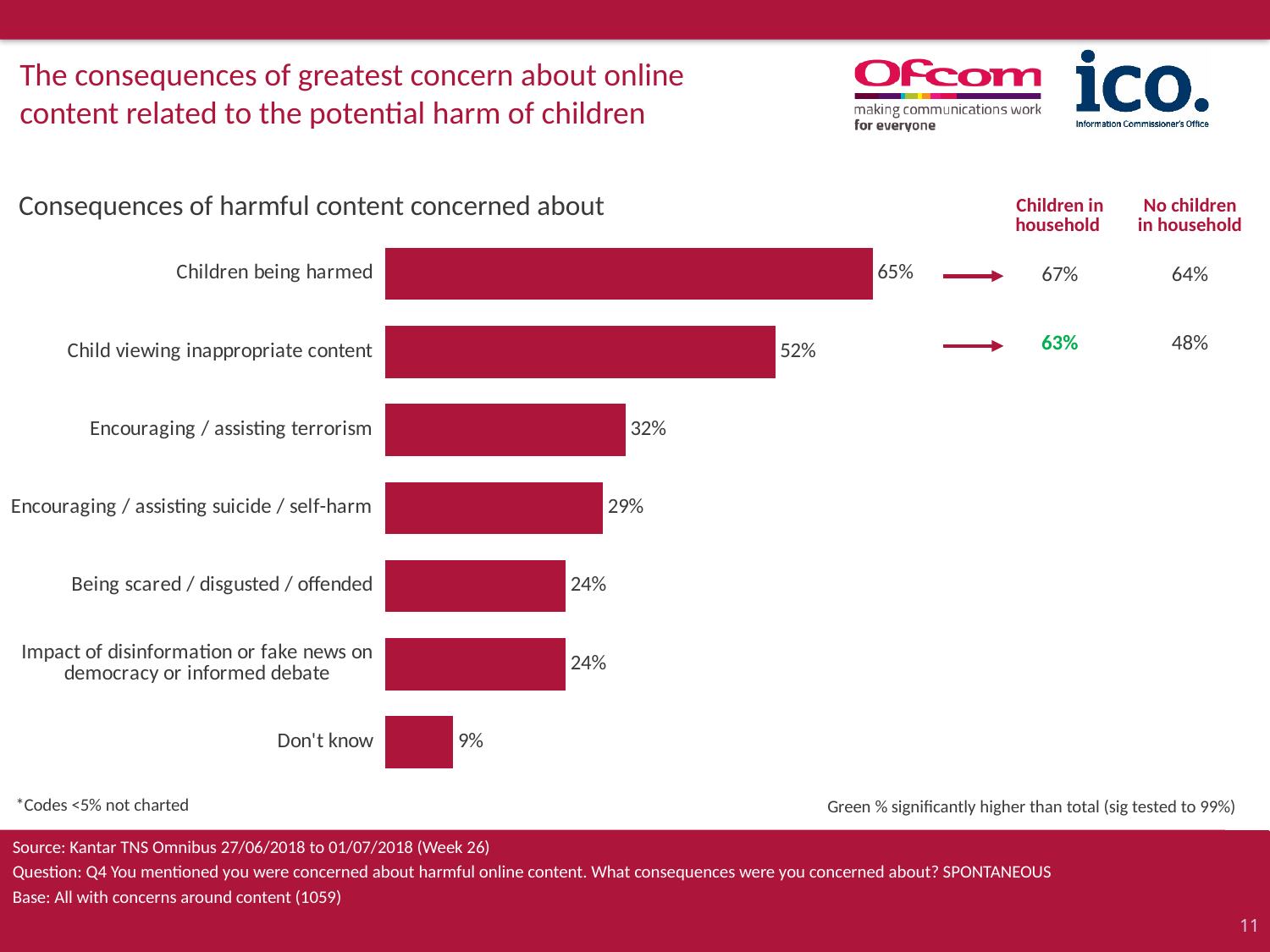
Which is larger: 'Encouraging / assisting terrorism' or 'Encouraging / assisting suicide / self-harm'? Encouraging / assisting terrorism Which consequence has the highest percentage? Children being harmed What is the value for 'Don't know'? 9% How many categories are shown in the bar chart? 7 What is the value for 'Child viewing inappropriate content' among those with children in the household? 63% What is the difference between 'Children being harmed' and 'Child viewing inappropriate content'? 13% What is the value for 'Encouraging / assisting terrorism'? 32% Which category has the lowest percentage? Don't know What percentage of respondents were concerned about children being harmed? 65% What is the value for 'Children being harmed' among those with no children in the household? 64% What type of chart is shown on the slide? Bar chart What is the title of the chart? Consequences of harmful content concerned about